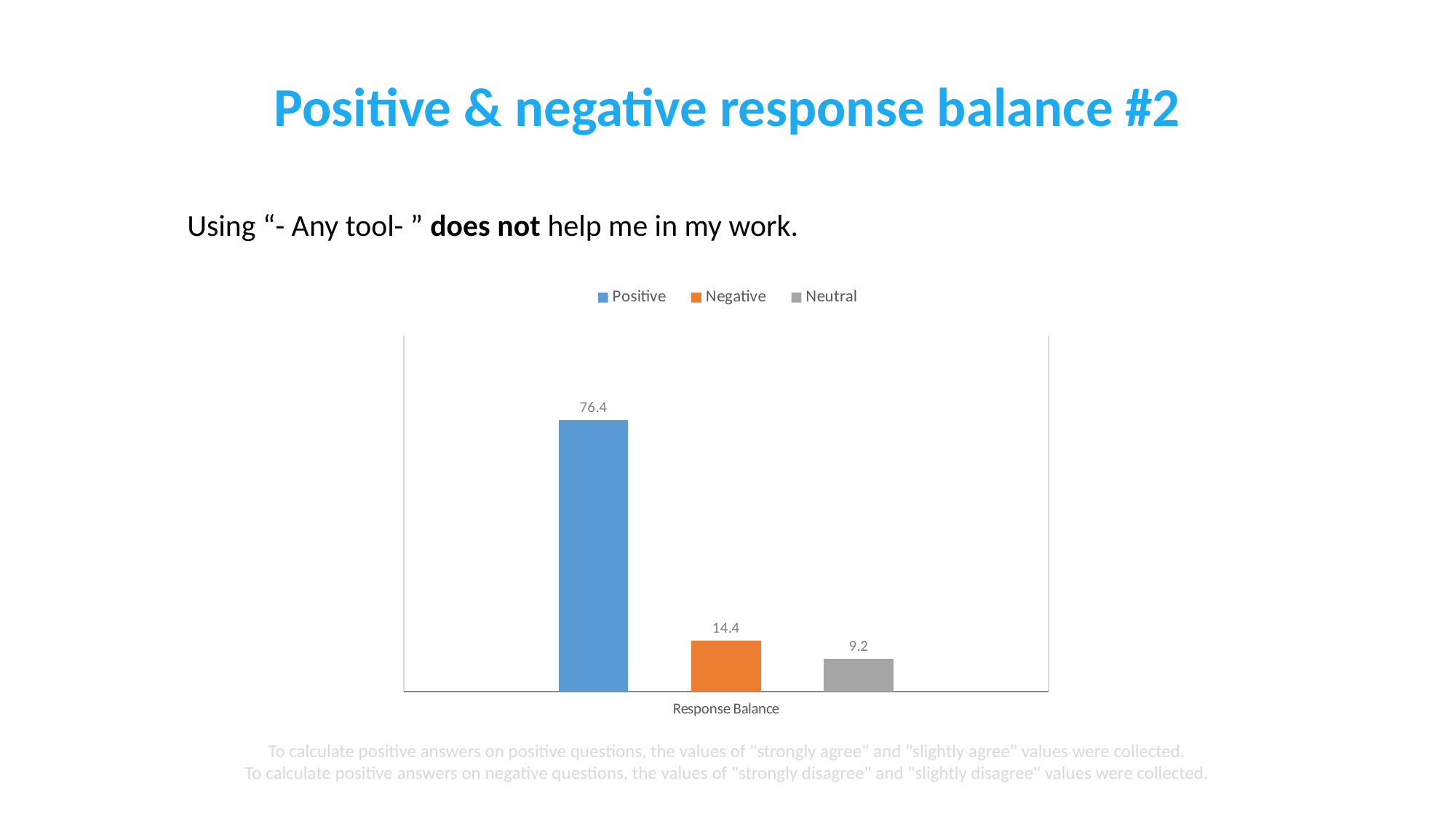
What is the total of the Positive, Negative and Neutral values? 100 What is the value of the Negative series in the Response Balance chart? 14.4 What is the difference between the Negative and Neutral values? 5.2 Which series has the lowest value in the chart? Neutral Which is larger, the Negative value or the Neutral value? Negative What is the label on the x axis of the chart? Response Balance What is the value of the Positive series in the Response Balance chart? 76.4 What is the value of the Neutral series in the Response Balance chart? 9.2 What kind of chart is shown on the slide? Bar chart Which series has the highest value in the chart? Positive What is the difference between the Positive and Negative values? 62 How many series does the legend list? 3